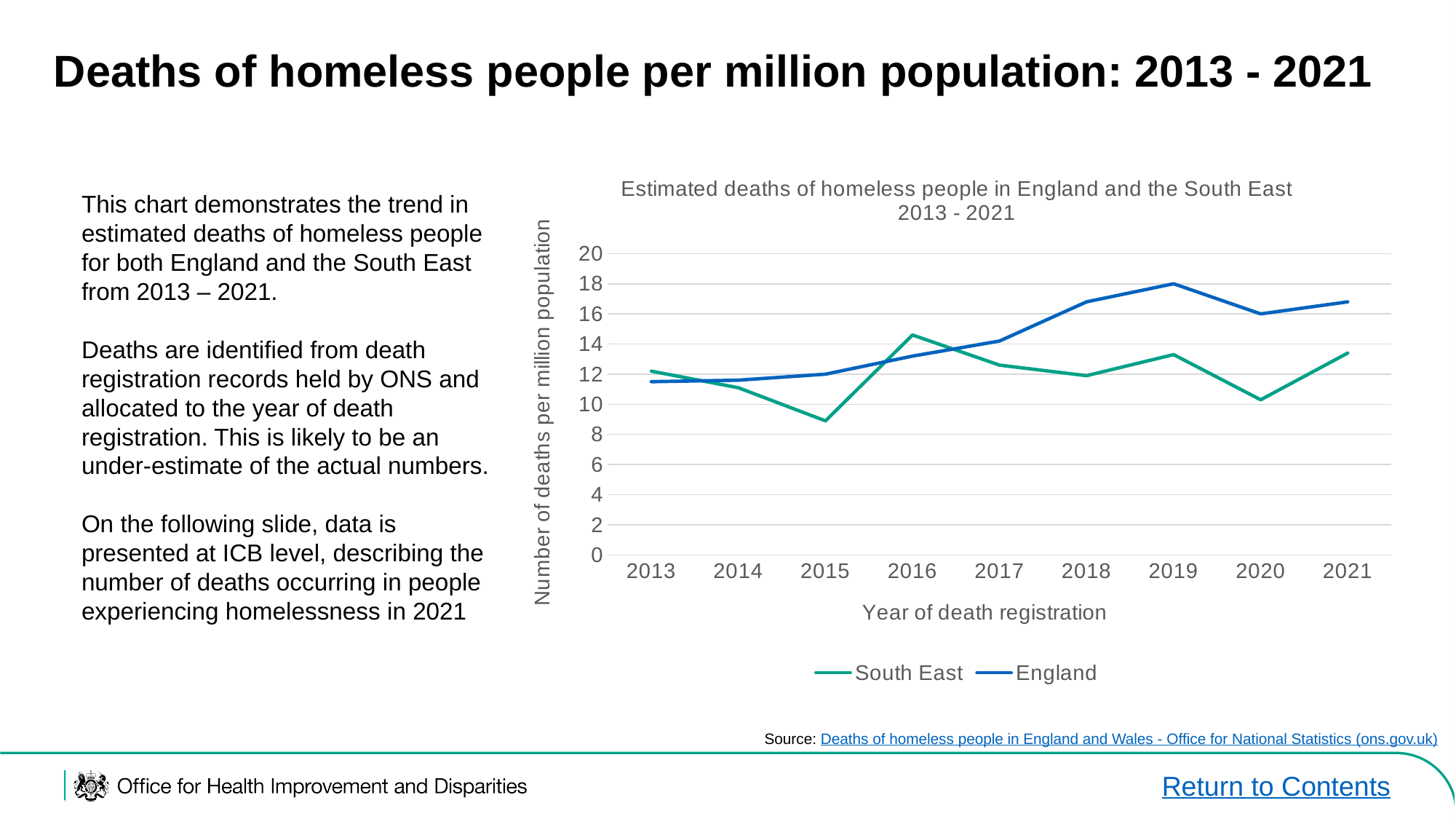
What kind of chart is shown on the slide? Line chart Is the value for South East in 2015 greater or less than 10? less Does the England line rise or fall between 2013 and 2019? Rise How many years are shown on the x axis of the chart? 9 In 2019, which series has the higher value, South East or England? England In which year does the South East line reach its highest value? 2016 Is the value for South East in 2020 greater or less than 12? less In which year does the England line reach its highest value? 2019 In 2016, which series has the higher value, South East or England? South East How many series does the chart legend list? 2 In which year does the South East line reach its lowest value? 2015 Is the value for England in 2019 greater or less than 16? greater